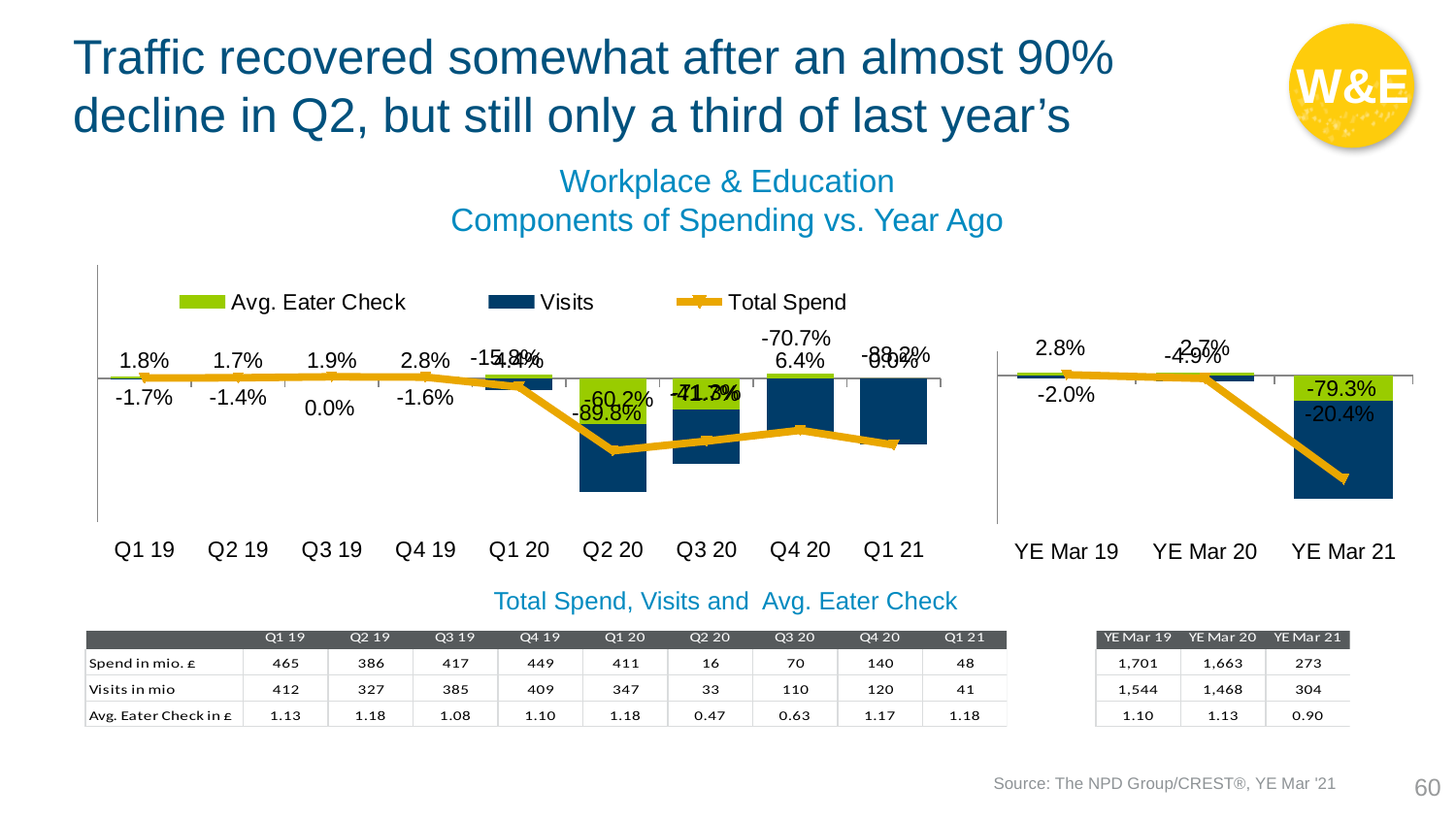
In the left chart, what is the Visits value for Q4 20? -70.7% In the left chart, what is the Avg. Eater Check value for Q1 19? 1.8% In the left chart, what is the Avg. Eater Check value for Q4 20? 6.4% In the right chart, what is the Avg. Eater Check value for YE Mar 19? 2.8% In the left chart, what is the Visits value for Q3 19? 0.0% In the right chart, does the Total Spend line rise or fall from YE Mar 19 to YE Mar 21? fall In the left chart, which quarter has the lowest Total Spend line value? Q2 20 In the right chart, what is the Visits value for YE Mar 21? -79.3% How many quarters are shown on the x axis of the left chart? 9 How many periods are shown on the x axis of the right chart? 3 What kind of chart is the left chart on the slide (Q1 19 to Q1 21)? bar chart with a line How many series does the legend of the left chart list? 3